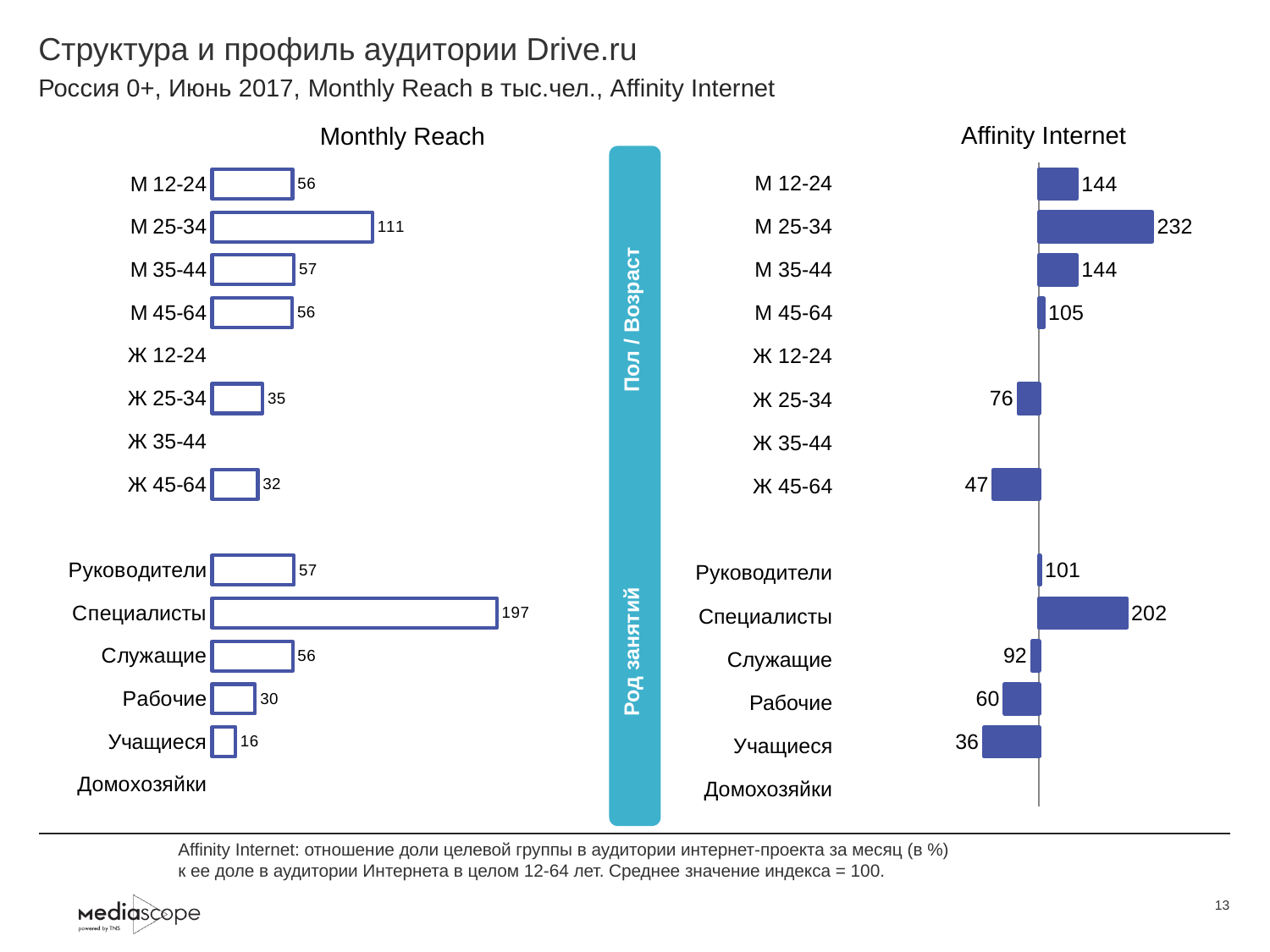
In the Affinity Internet chart, what is the value for М 25-34? 232 In the Affinity Internet chart, what is the difference between the values for Специалисты and Руководители? 101 In the Monthly Reach chart, what is the value for Специалисты? 197 In the Monthly Reach chart, what is the difference between the values for М 25-34 and Ж 25-34? 76 In the Affinity Internet chart, which category has the lowest value? Учащиеся In the Affinity Internet chart, which is larger: the value for Ж 25-34 or the value for Ж 45-64? Ж 25-34 In the Monthly Reach chart, which category has the highest value? Специалисты In the Affinity Internet chart, what is the value for Служащие? 92 What kind of chart is the Affinity Internet chart? Bar chart In the Monthly Reach chart, which is larger: the value for Рабочие or the value for Учащиеся? Рабочие In the Monthly Reach chart, what is the value for М 25-34? 111 In the Affinity Internet chart, what is the value for Учащиеся? 36